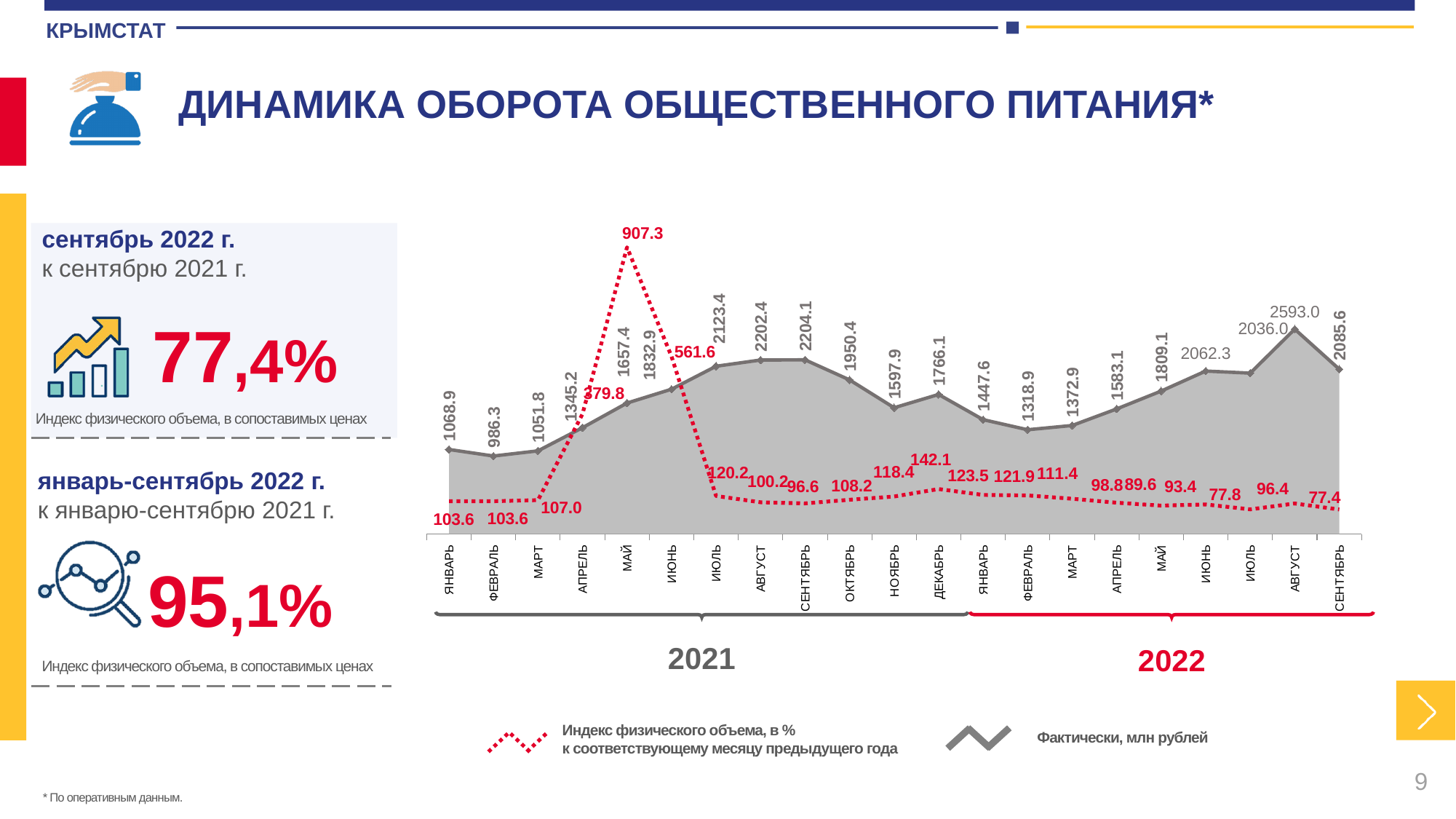
What is the difference in actual turnover between August 2022 (2593.0) and September 2022 (2085.6)? 507.4 How many series does the chart legend list? 2 Which is larger: the actual turnover for July 2021 or for July 2022? July 2021 What is the actual turnover (Фактически, млн рублей) for August 2022? 2593.0 Does the physical volume index rise or fall from January 2022 to September 2022? Fall What kind of chart is used to show the actual turnover in million rubles? Area chart How many months are plotted on the x axis of the chart? 21 What is the actual turnover in million rubles for September 2021? 2204.1 Which month has the lowest actual turnover (млн рублей) on the chart? Февраль 2021 What is the physical volume index for September 2022? 77.4 Which month has the highest actual turnover (млн рублей) on the chart? Август 2022 What is the physical volume index (Индекс физического объема, в %) for May 2021? 907.3